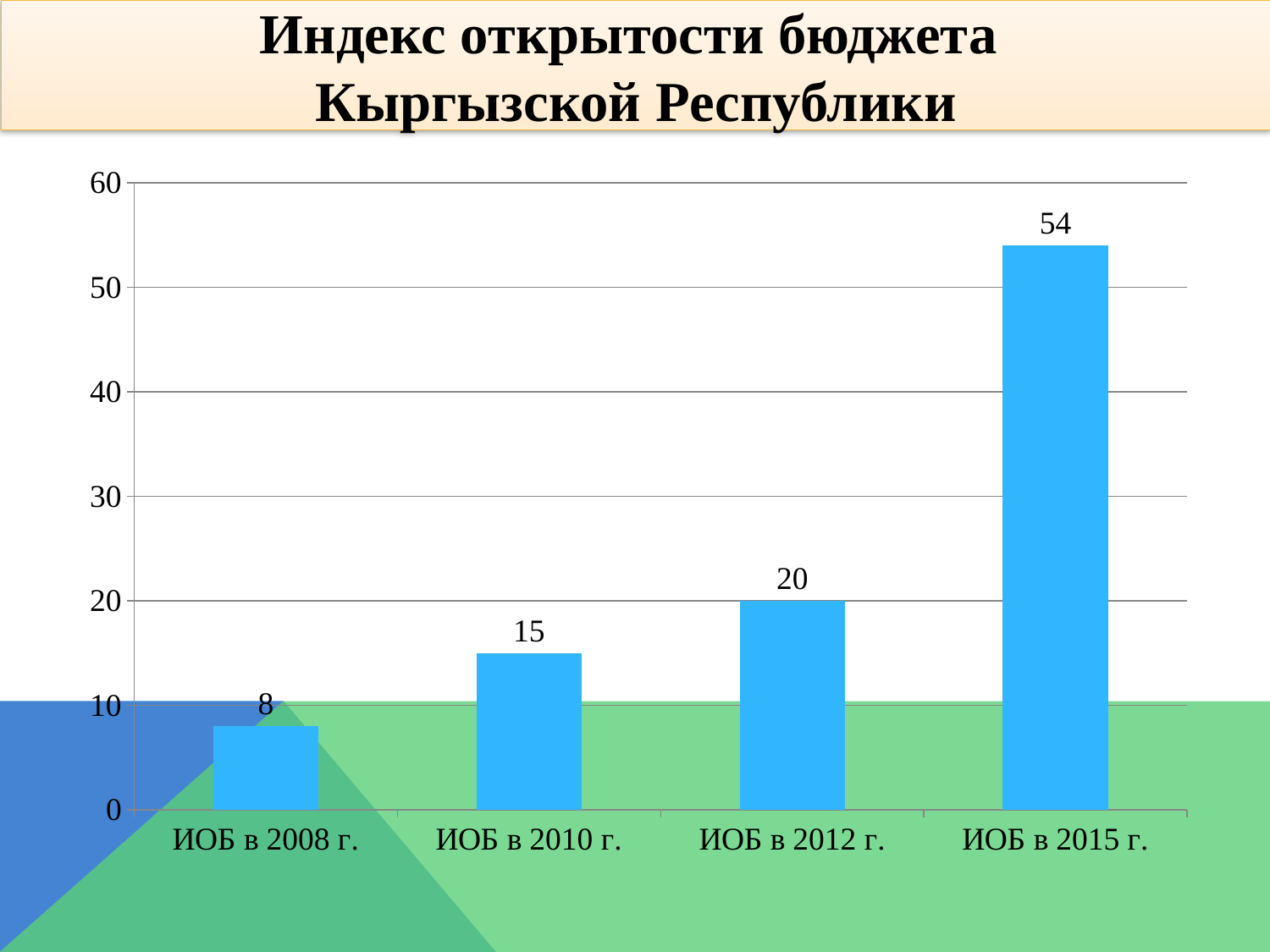
What kind of chart is shown on the slide? Bar chart Do the values rise or fall from ИОБ в 2008 г. to ИОБ в 2015 г.? Rise How many categories are shown on the chart? 4 What is the value for ИОБ в 2015 г.? 54 What is the value for ИОБ в 2010 г.? 15 Which category has the lowest value? ИОБ в 2008 г. What is the value for ИОБ в 2012 г.? 20 What is the difference between the values for ИОБ в 2010 г. and ИОБ в 2008 г.? 7 Which category has the highest value? ИОБ в 2015 г. What is the difference between the values for ИОБ в 2015 г. and ИОБ в 2012 г.? 34 Which is larger, the value for ИОБ в 2012 г. or ИОБ в 2010 г.? ИОБ в 2012 г. What is the value for ИОБ в 2008 г.? 8